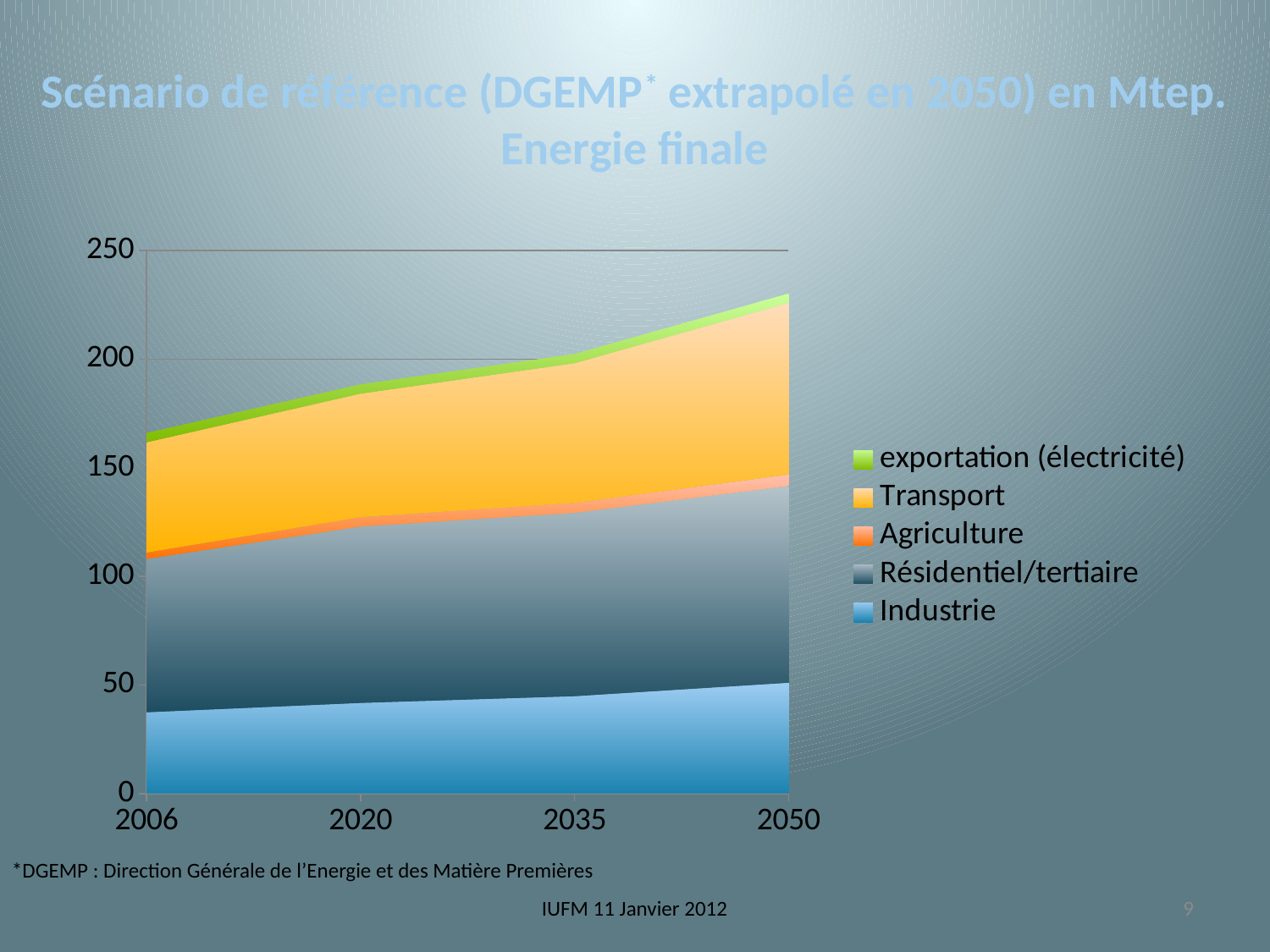
Is the value for Industrie in 2006 greater or less than 50? less Is the total stacked value for 2050 greater or less than 200? greater Which year has the highest total stacked value? 2050 What kind of chart is shown on the slide? Stacked area chart How many series does the legend list? 5 Does the total stacked value rise or fall from 2006 to 2050? rise How many years are shown along the x axis? 4 Which series is at the top of the stack? exportation (électricité) Which series is at the bottom of the stack? Industrie Is the total stacked value for 2006 greater or less than 150? greater